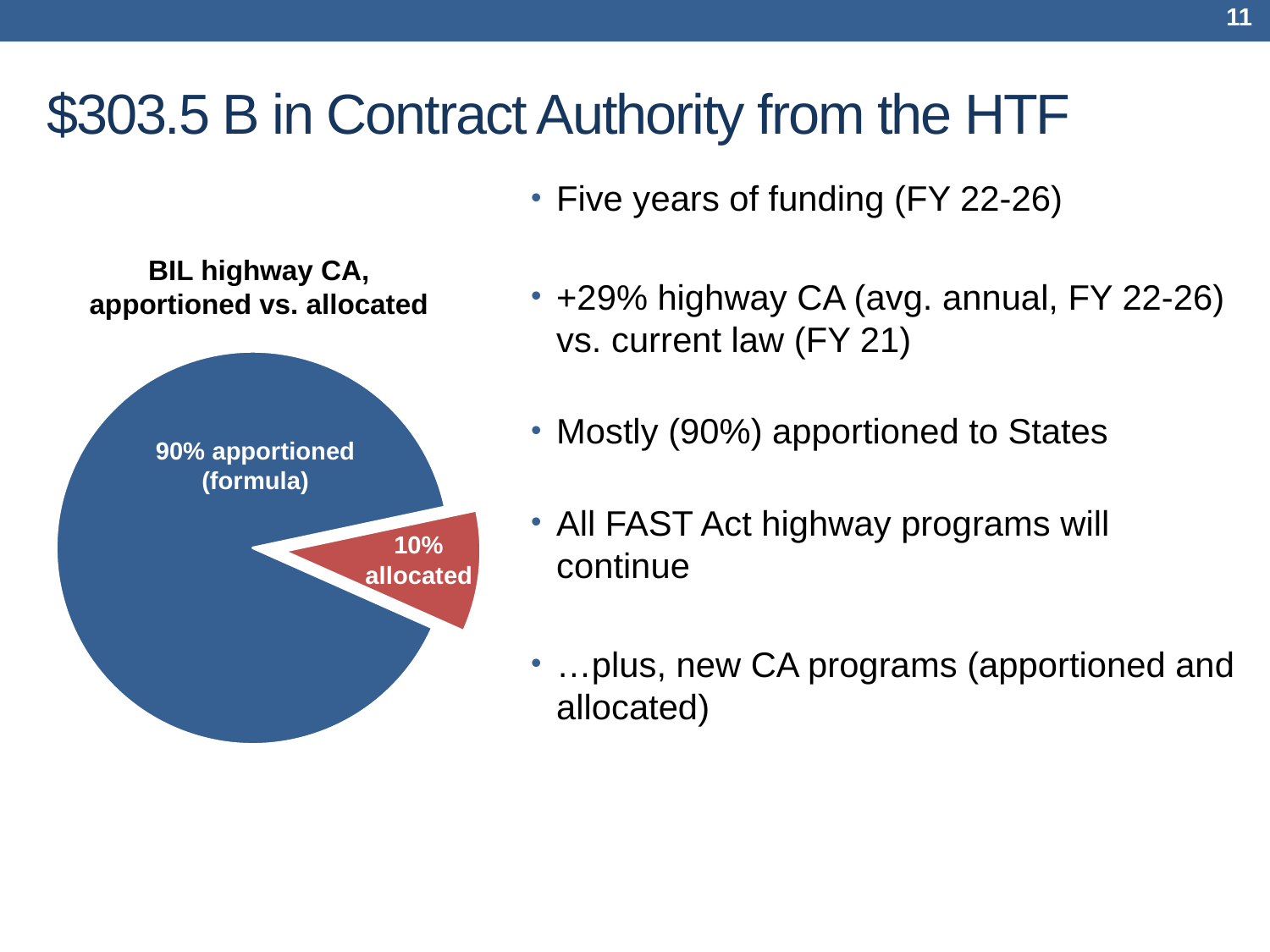
What colour is the allocated slice of the pie chart? red Is the apportioned share greater or less than 50%? greater What kind of chart is shown on the slide? pie chart Which slice of the pie chart is the smallest? 10% allocated Which slice of the pie chart is the largest? 90% apportioned (formula) What is the difference in percentage points between the apportioned and allocated shares? 80 percentage points What is the title of the pie chart? BIL highway CA, apportioned vs. allocated Which is larger, the apportioned share or the allocated share? apportioned What share of BIL highway CA is allocated? 10% How many slices does the pie chart have? 2 What share of BIL highway CA is apportioned (formula)? 90%